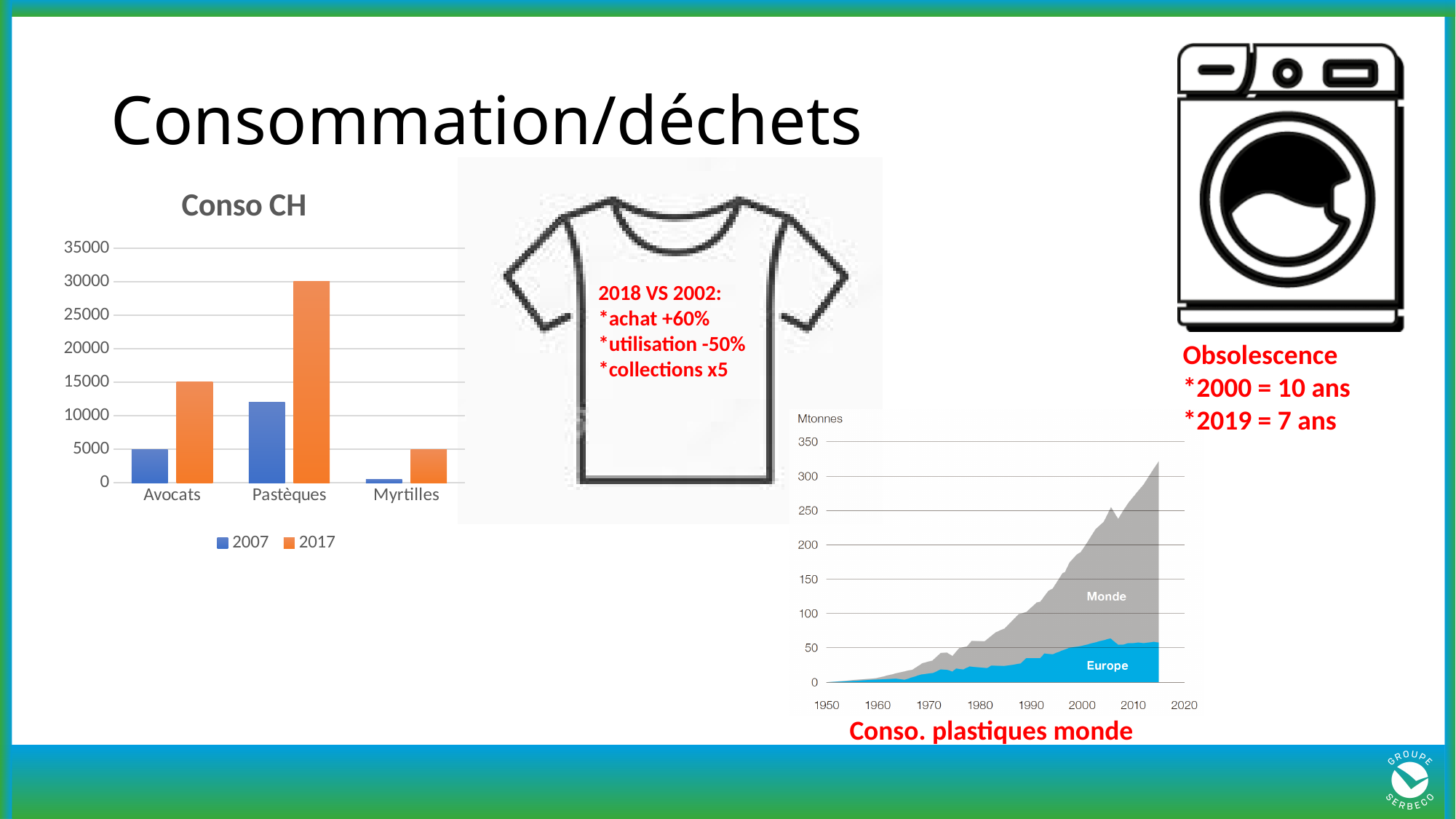
What kind of chart is the 'Conso CH' chart? bar chart In the 'Conso CH' chart, which category has the lowest 2007 value? Myrtilles What kind of chart is the 'Conso. plastiques monde' chart? area chart In the 'Conso CH' chart, which category has the highest 2017 value? Pastèques In the 'Conso CH' chart, is the 2007 value for Pastèques greater or less than 10000? greater How many series does the legend of the 'Conso CH' chart list? 2 In the 'Conso CH' chart, which is larger for Avocats: the 2007 value or the 2017 value? 2017 In the 'Conso. plastiques monde' chart, does the Monde value rise or fall from 1950 to 2010? rise In the 'Conso CH' chart, is the 2007 value for Myrtilles greater or less than 5000? less In the 'Conso CH' chart, is the 2017 value for Pastèques greater or less than 25000? greater In the 'Conso CH' chart, which colour represents the 2017 series? orange How many categories are shown on the x axis of the 'Conso CH' chart? 3